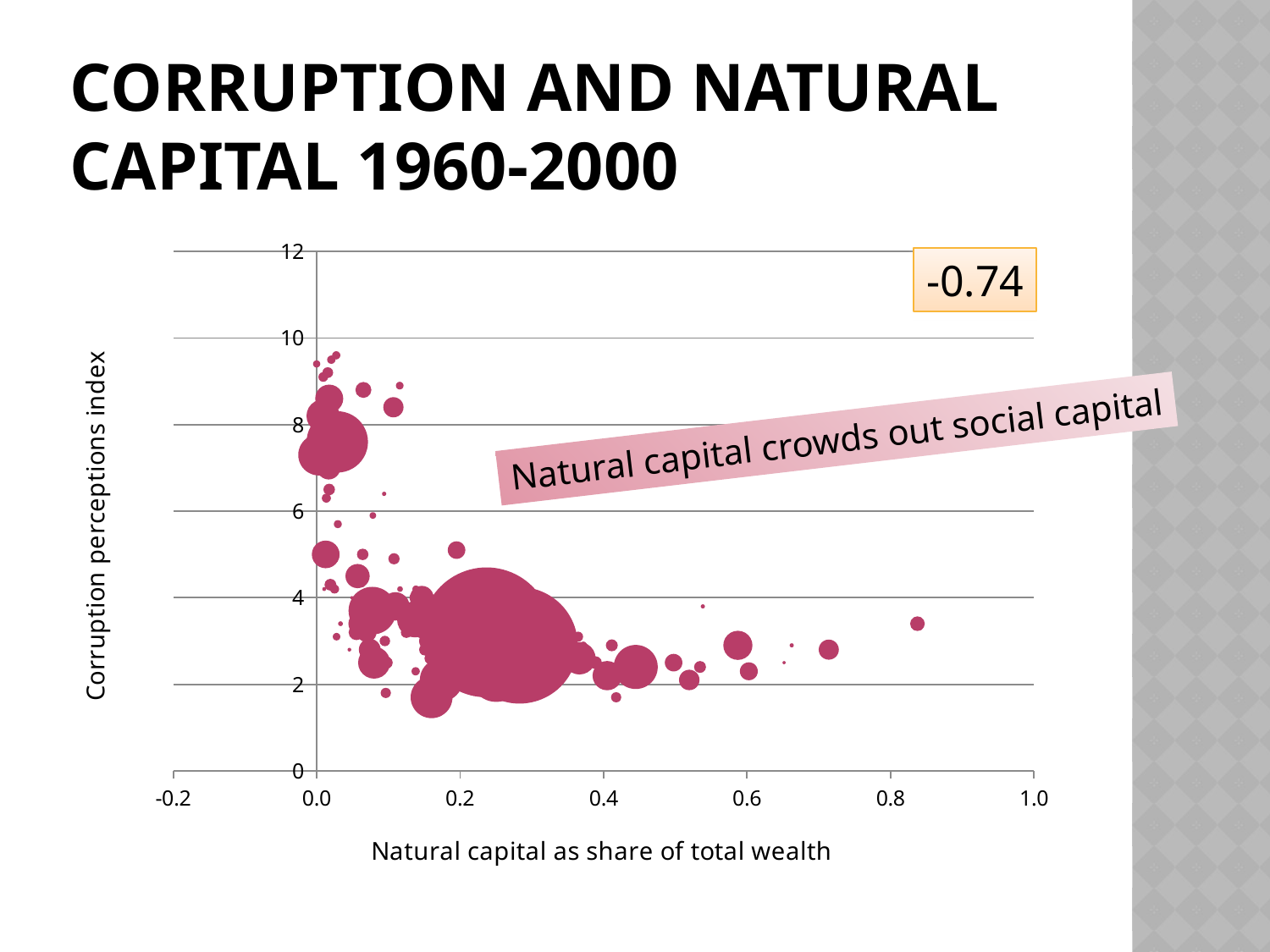
As natural capital as a share of total wealth increases along the x axis, does the corruption perceptions index generally rise or fall? Fall Are the bubbles with a natural capital share above 0.4 plotted above or below a corruption perceptions index of 6? below What number is shown in the box at the top right of the chart? -0.74 Is the corruption perceptions index for the bubble with the largest natural capital share (near 0.84) greater or less than 6? less What is the label of the x axis? Natural capital as share of total wealth Is the corruption perceptions index for the largest bubble (centred near a natural capital share of 0.25) greater or less than 6? less What kind of chart is shown on the slide? Bubble chart